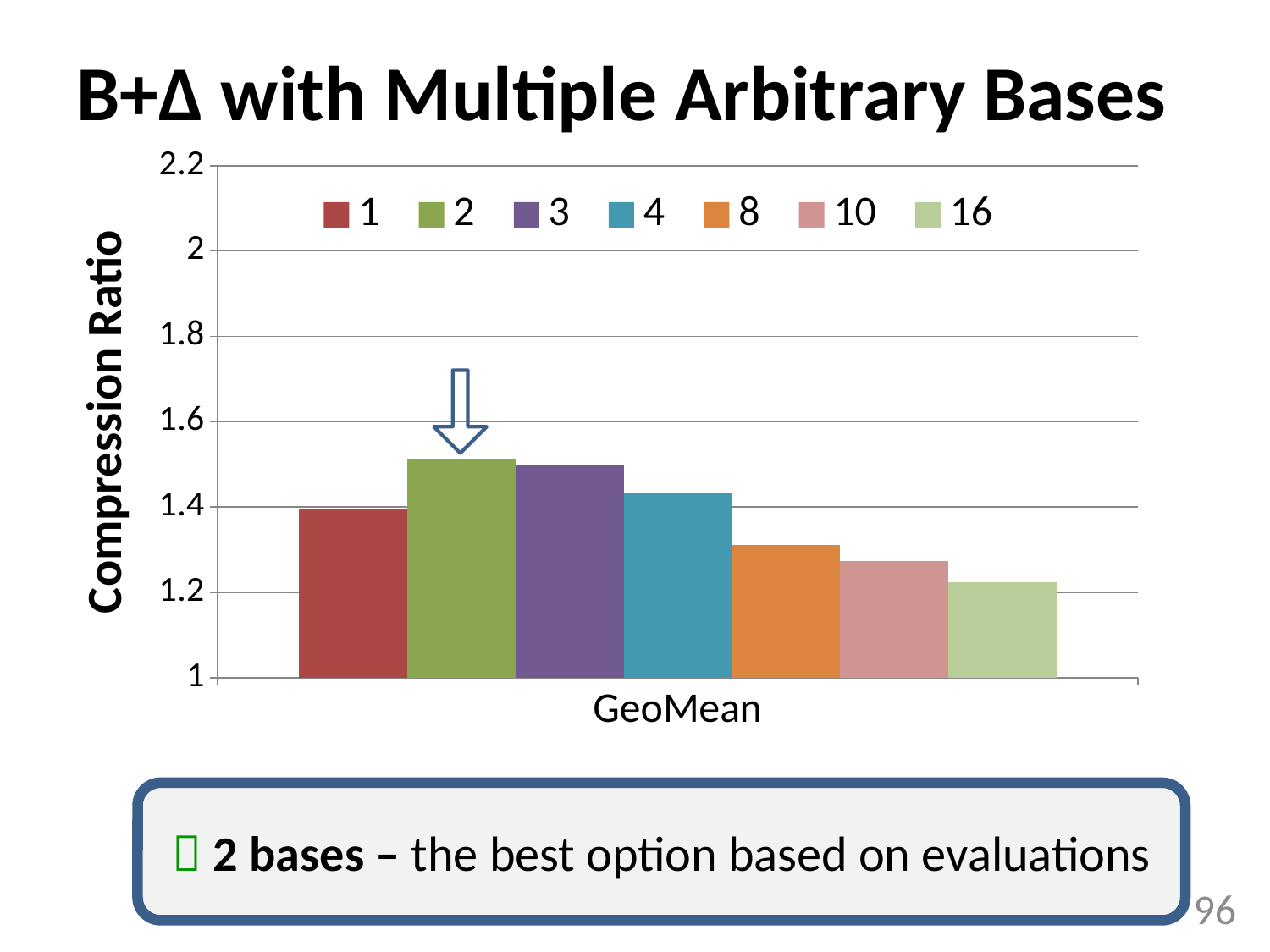
Is the value for series 8 greater or less than 1.4? less What kind of chart is shown on the slide? bar chart How many series does the legend list? 7 Is the value for series 10 greater or less than 1.2? greater What is the title of the y axis? Compression Ratio What is the label of the category on the x axis? GeoMean How many categories are shown on the x axis? 1 Which is larger, the value for series 2 or the value for series 16? 2 Which is larger, the value for series 4 or the value for series 8? 4 Is the value for series 2 greater or less than 1.4? greater Which series has the lowest compression ratio? 16